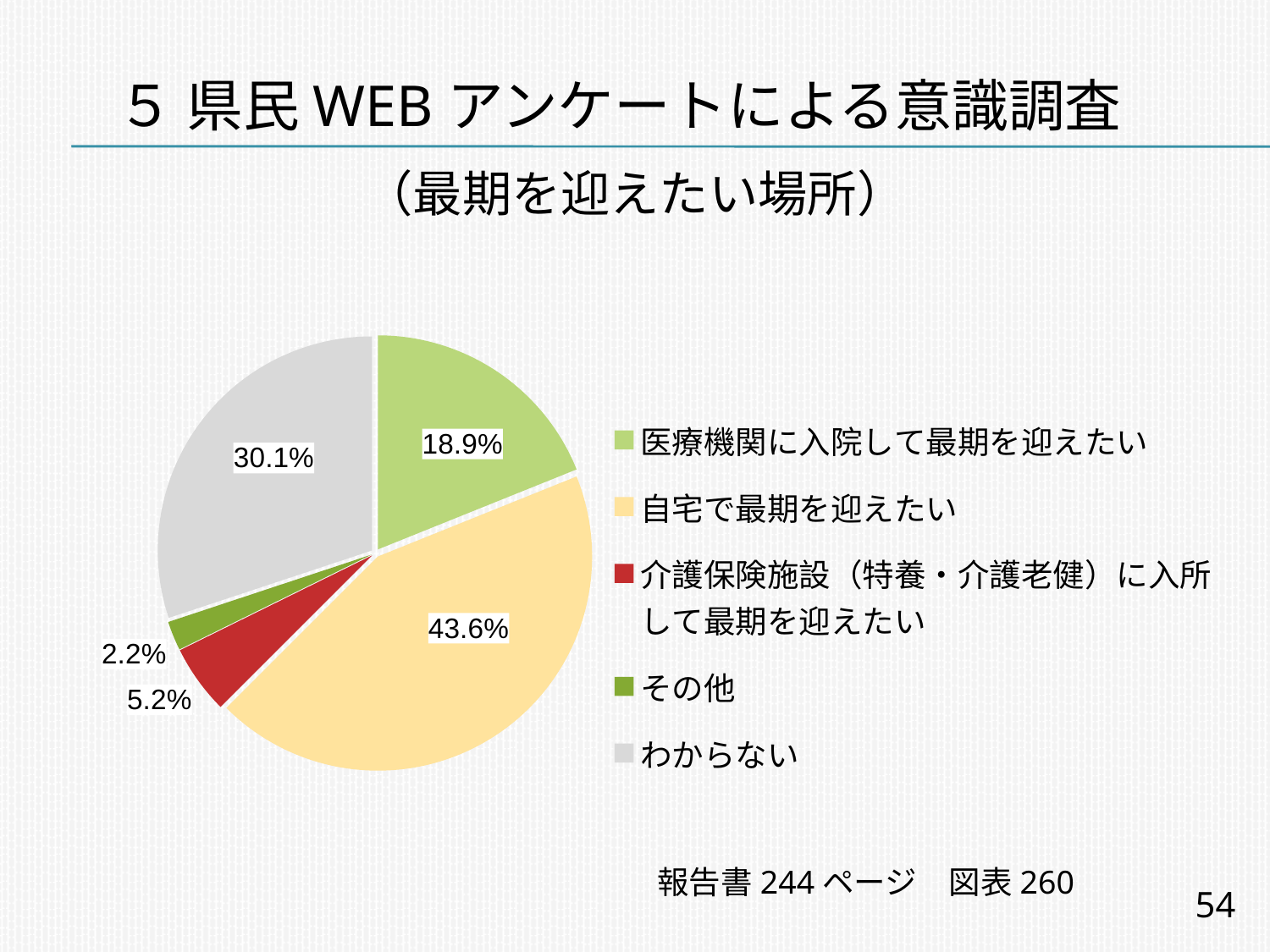
Which category has the largest share of the pie? 自宅で最期を迎えたい What type of chart is shown on the slide? Pie chart What percentage is shown for 介護保険施設（特養・介護老健）に入所して最期を迎えたい? 5.2% What is the difference in percentage points between 自宅で最期を迎えたい and わからない? 13.5 What share is shown for 医療機関に入院して最期を迎えたい? 18.9% What colour is the slice for わからない? Grey Which is larger: the share for 医療機関に入院して最期を迎えたい or the share for わからない? わからない What percentage of respondents chose 自宅で最期を迎えたい? 43.6% What percentage is shown for その他? 2.2% What percentage of respondents answered わからない? 30.1% Which category has the smallest share of the pie? その他 How many categories does the pie chart show? 5